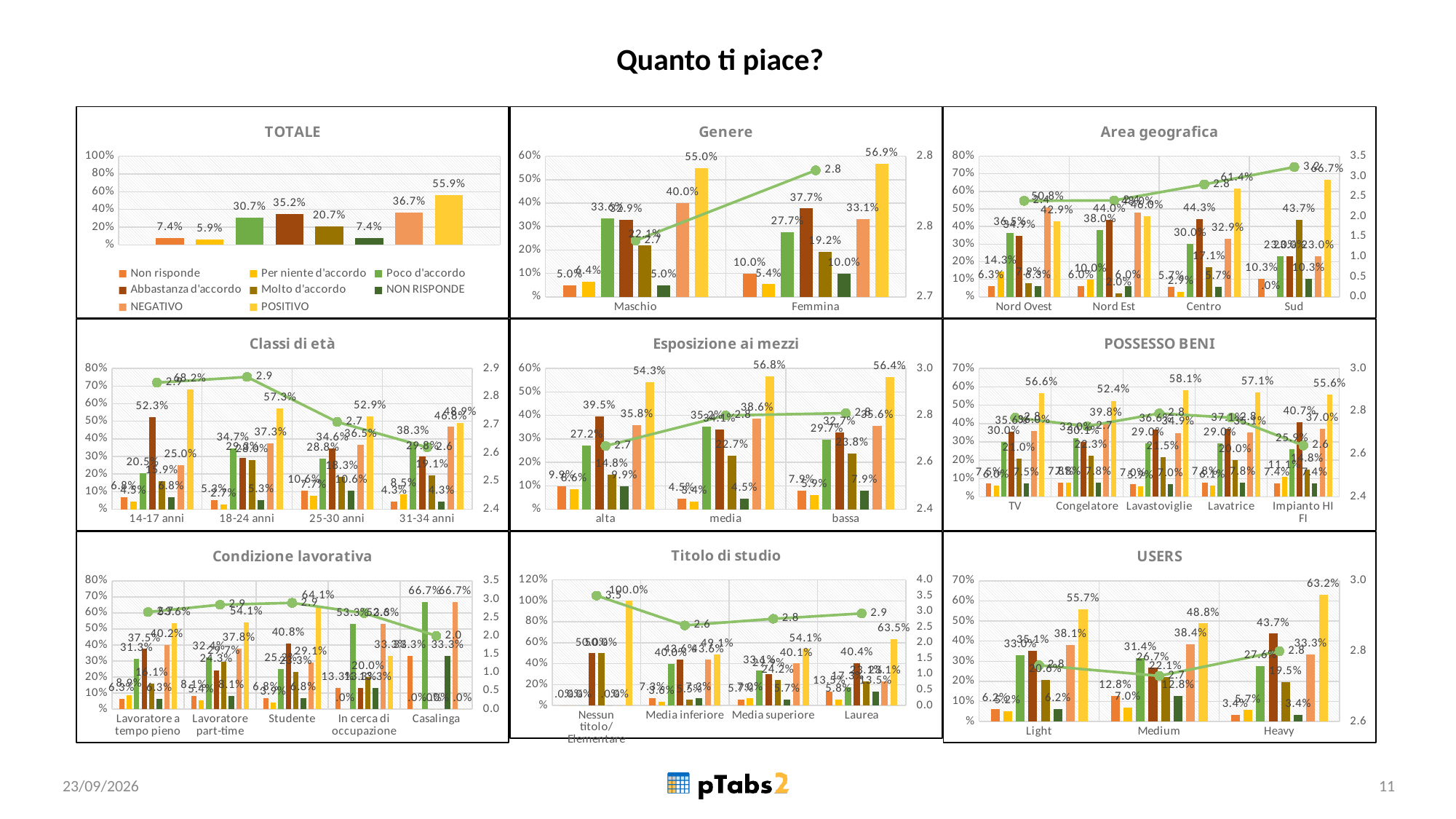
In the Genere chart, what is the difference between the POSITIVO values for Femmina and Maschio? 1.9% In the POSSESSO BENI chart, which item has the lowest POSITIVO value? Congelatore In the TOTALE chart, what is the value for Abbastanza d'accordo? 35.2% How many series does the legend of the TOTALE chart list? 8 In the Area geografica chart, which area has the highest POSITIVO value? Sud How many categories are shown on the x axis of the Esposizione ai mezzi chart? 3 In the Titolo di studio chart, what is the POSITIVO value for Laurea? 63.5% In the Genere chart, what is the POSITIVO value for Femmina? 56.9% In the Area geografica chart, what is the POSITIVO value for Centro? 61.4% In the USERS chart, which is larger, the POSITIVO value for Light or for Medium? Light In the Classi di età chart, does the POSITIVO value rise or fall from 14-17 anni to 31-34 anni? fall In the TOTALE chart, what is the value for POSITIVO? 55.9%